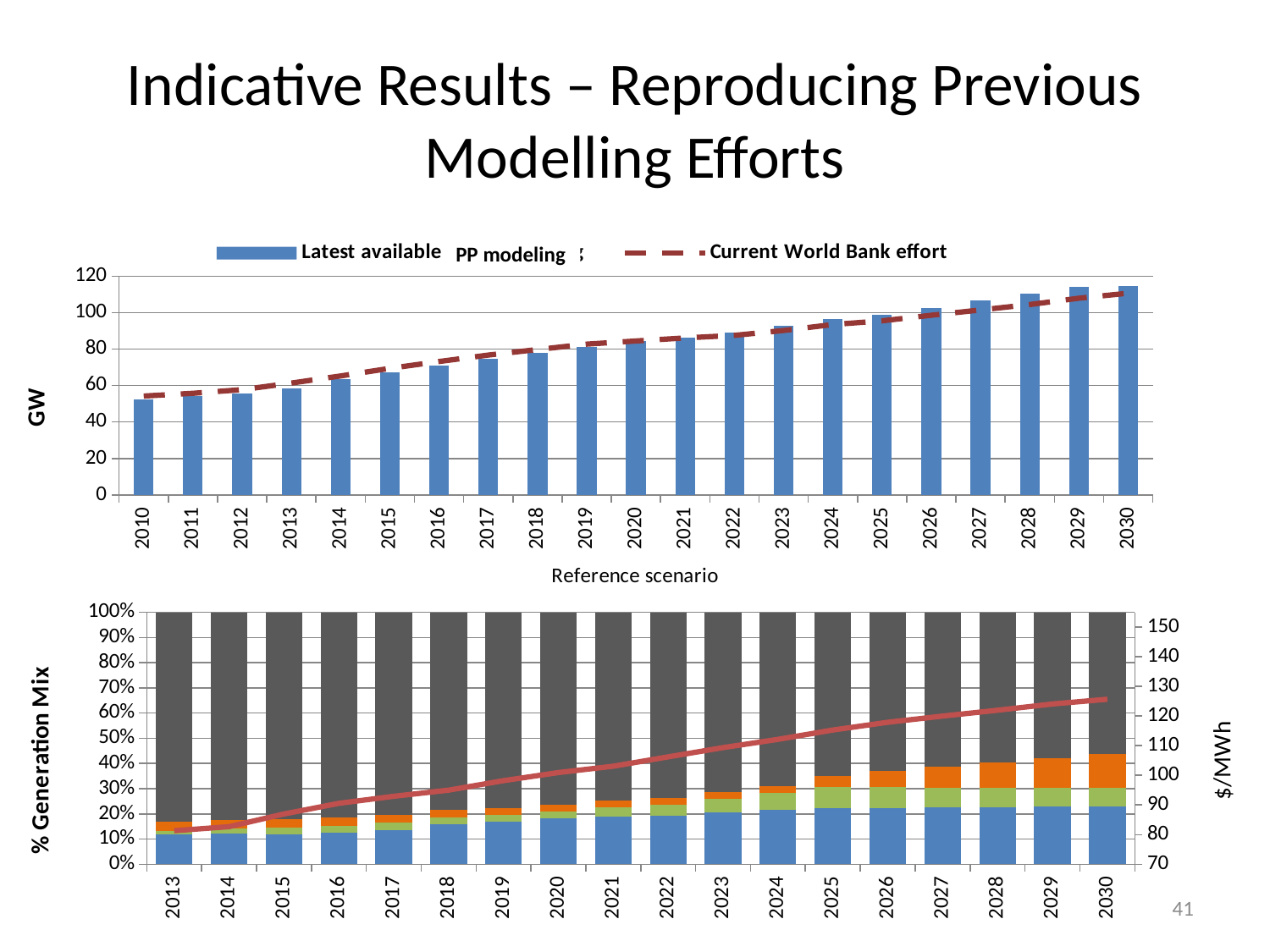
What type of chart is the top chart on the slide? combination bar and line chart In the top chart, which year has the highest bar? 2030 In the top chart, which year has the lowest bar? 2010 What is the label on the right-hand vertical axis of the bottom chart? $/MWh In the top chart, is the bar value for 2010 greater or less than 60? less What is the label on the vertical axis of the top chart? GW In the bottom chart, how many years are shown on the x axis? 18 In the bottom chart, is the line value for 2030 on the right-hand axis greater or less than 120? greater In the top chart, is the bar value for 2028 greater or less than 100? greater In the top chart, how many series does the legend list? 2 In the top chart, how many years are shown on the x axis? 21 In the top chart, do the bar values rise or fall from 2010 to 2030? rise